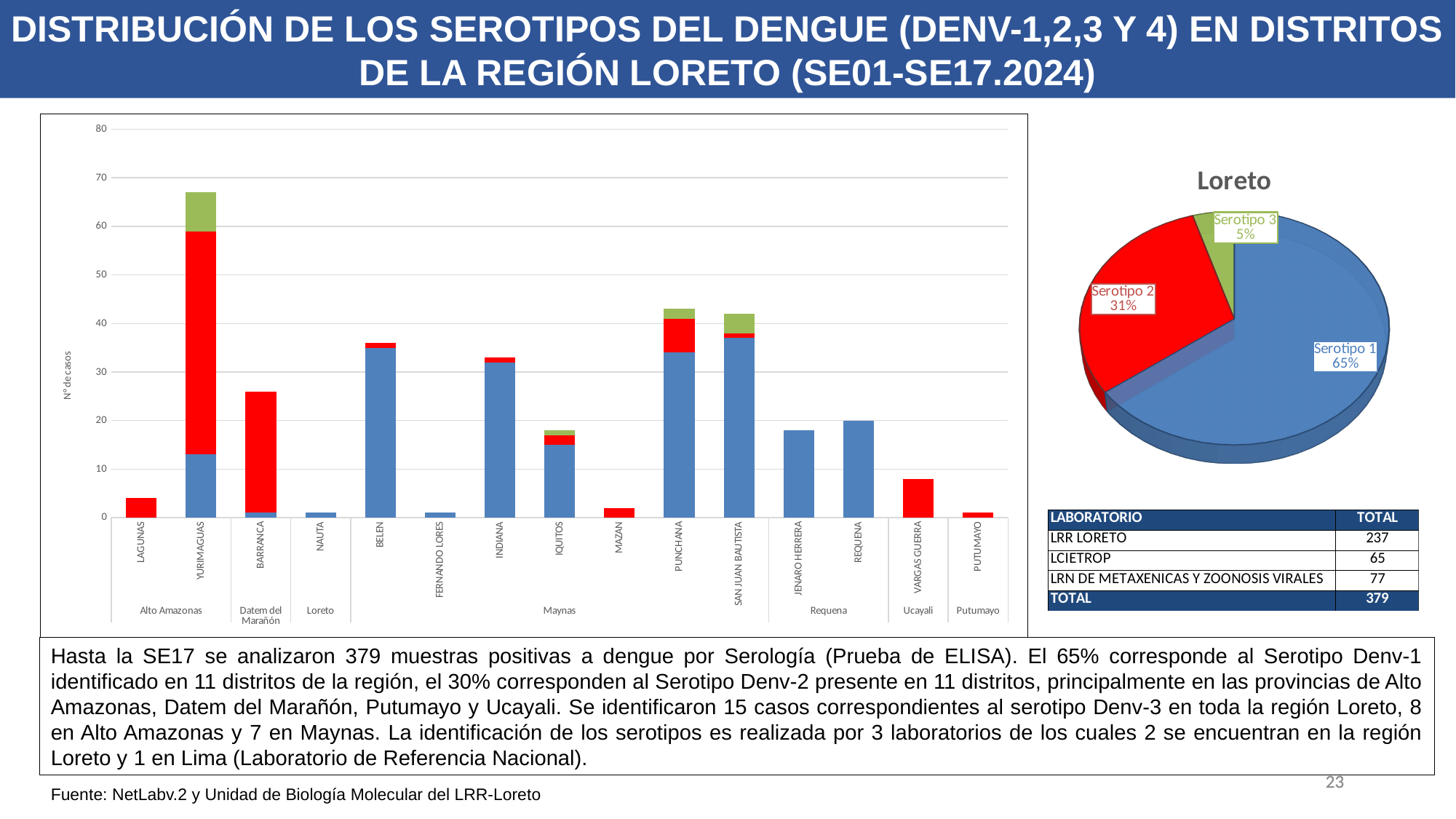
In the pie chart titled Loreto, which serotype has the smallest slice? Serotipo 3 In the bar chart on the left, is the total value for Belen greater or less than 40? less In the pie chart titled Loreto, what share does Serotipo 3 have? 5% In the bar chart on the left, how many districts are shown on the x axis? 15 What kind of chart is the chart on the left side of the slide? Bar chart In the bar chart on the left, which district has the tallest bar? Yurimaguas In the pie chart titled Loreto, what share does Serotipo 2 have? 31% In the pie chart titled Loreto, which serotype has the largest slice? Serotipo 1 In the pie chart titled Loreto, what share does Serotipo 1 have? 65% In the pie chart titled Loreto, how many percentage points larger is Serotipo 1's share than Serotipo 2's share? 34 In the bar chart on the left, is the total value for Yurimaguas greater or less than 60? greater In the pie chart titled Loreto, how many slices are there? 3